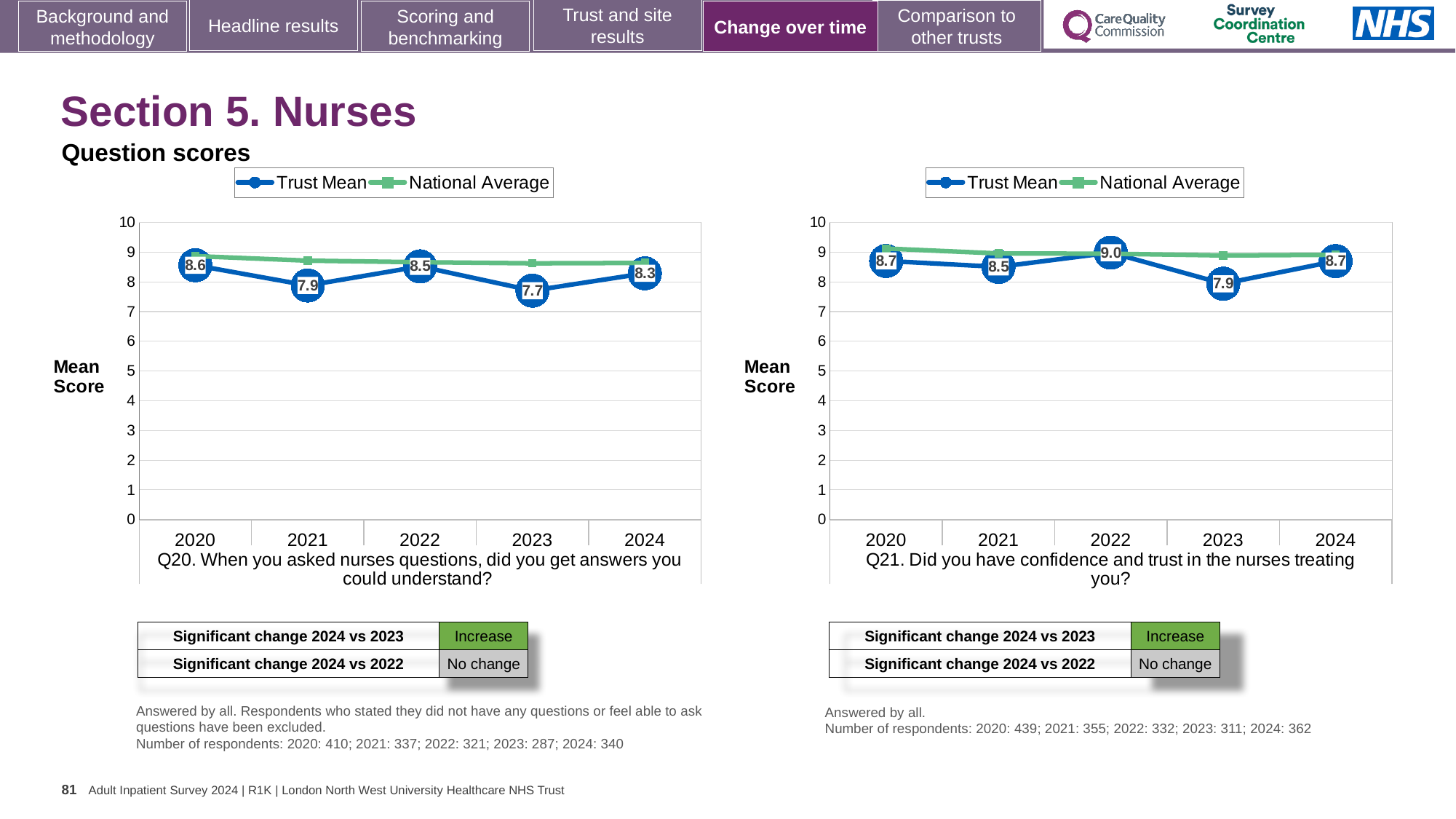
In the Q21 chart (right), what is the difference between the Trust Mean scores for 2022 and 2023? 1.1 In the Q20 chart (left), does the Trust Mean score rise or fall from 2023 to 2024? Rise In the Q21 chart (right), what is the Trust Mean score for 2022? 9.0 In the Q20 chart (left), is the National Average value for 2020 greater or less than 8? greater In the Q21 chart (right), which year has the lowest Trust Mean score? 2023 In the Q21 chart (right), which is larger: the Trust Mean score for 2021 or for 2024? 2024 What kind of chart is the Q20 chart (left)? Line chart In the Q20 chart (left), what is the Trust Mean score for 2023? 7.7 How many series does the legend of the Q21 chart (right) list? 2 In the Q20 chart (left), which year has the highest Trust Mean score? 2020 How many years are shown on the x axis of the Q20 chart (left)? 5 In the Q20 chart (left), what is the difference between the Trust Mean scores for 2020 and 2021? 0.7